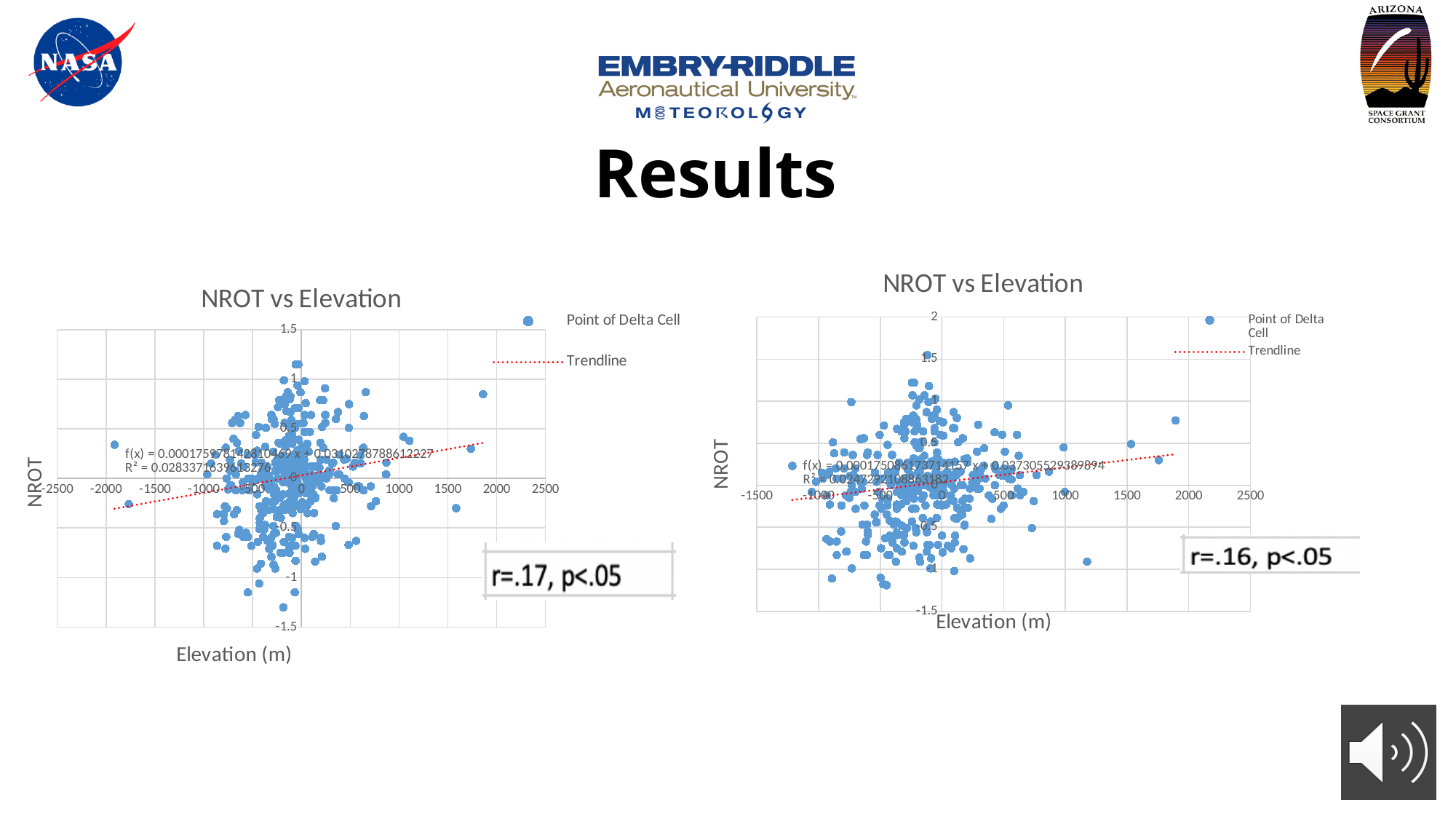
In the left chart, does the trendline rise or fall as elevation increases? Rises What is the highest value shown on the y axis of the right chart? 2 What is the title of the left chart? NROT vs Elevation Which chart reports the larger correlation coefficient r, the left chart or the right chart? The left chart What are the two legend entries of the right chart? Point of Delta Cell; Trendline In the right chart, does the trendline rise or fall as elevation increases? Rises What correlation coefficient r is reported in the text box on the right chart? r=.16 How many series does the legend of the left chart list? 2 How many series does the legend of the right chart list? 2 What kind of chart is the chart on the left of the slide? Scatter chart What correlation coefficient r is reported in the text box on the left chart? r=.17 What kind of chart is the chart on the right of the slide? Scatter chart